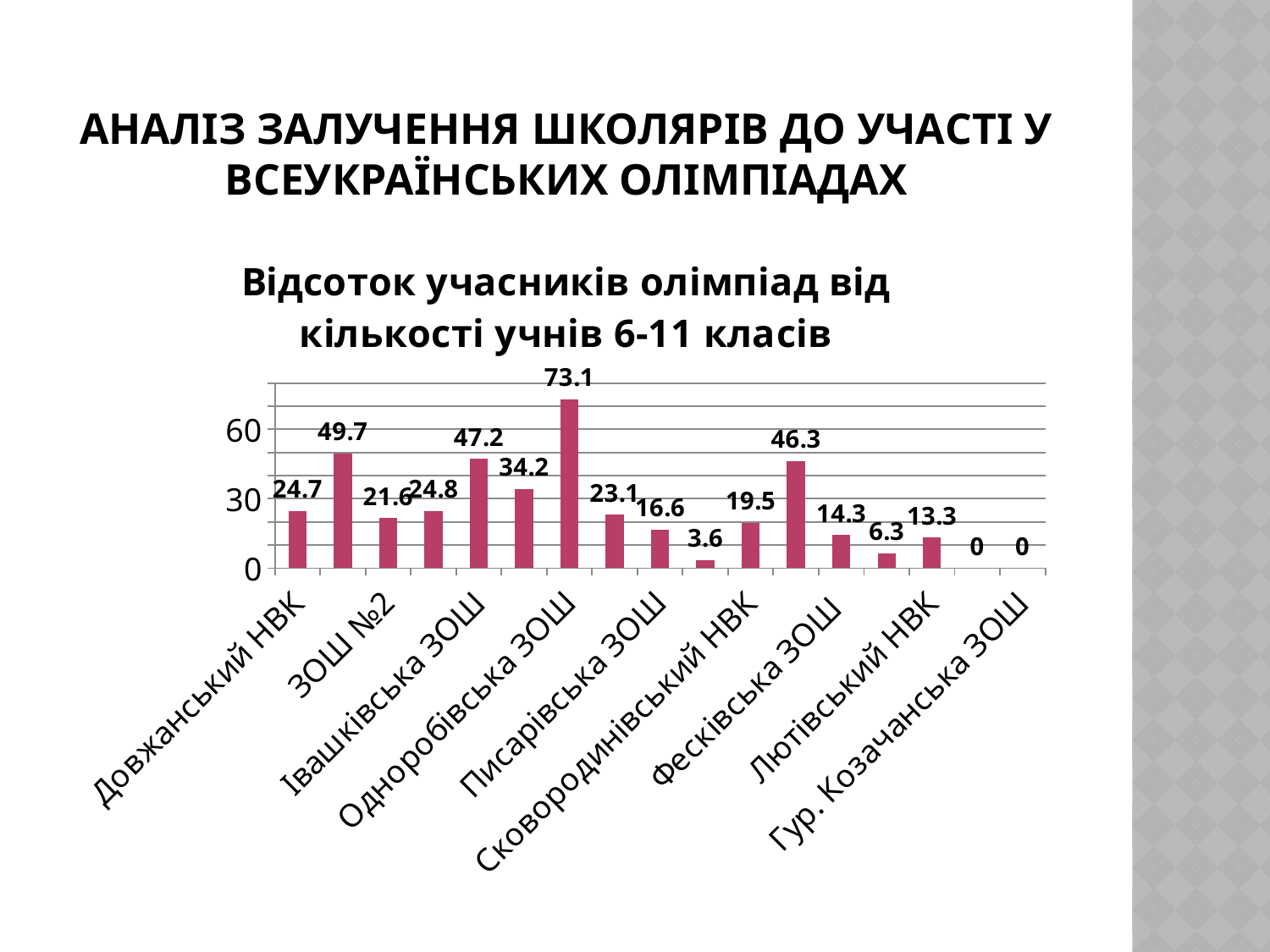
Is the value for Одноробівська ЗОШ greater or less than 60? greater What is the difference between the values for Івашківська ЗОШ and ЗОШ №2? 25.6 What is the value for Одноробівська ЗОШ? 73.1 What is the value for Довжанський НВК? 24.7 What is the value for Івашківська ЗОШ? 47.2 Which is larger, the value for Довжанський НВК or for Сковородинівський НВК? Довжанський НВК How many bars are plotted in the chart? 17 What is the value for Гур. Козачанська ЗОШ? 0 What is the title of the chart? Відсоток учасників олімпіад від кількості учнів 6-11 класів Which labelled school has the highest value in the chart? Одноробівська ЗОШ What is the highest value shown in the chart? 73.1 What type of chart is shown on the slide? bar chart